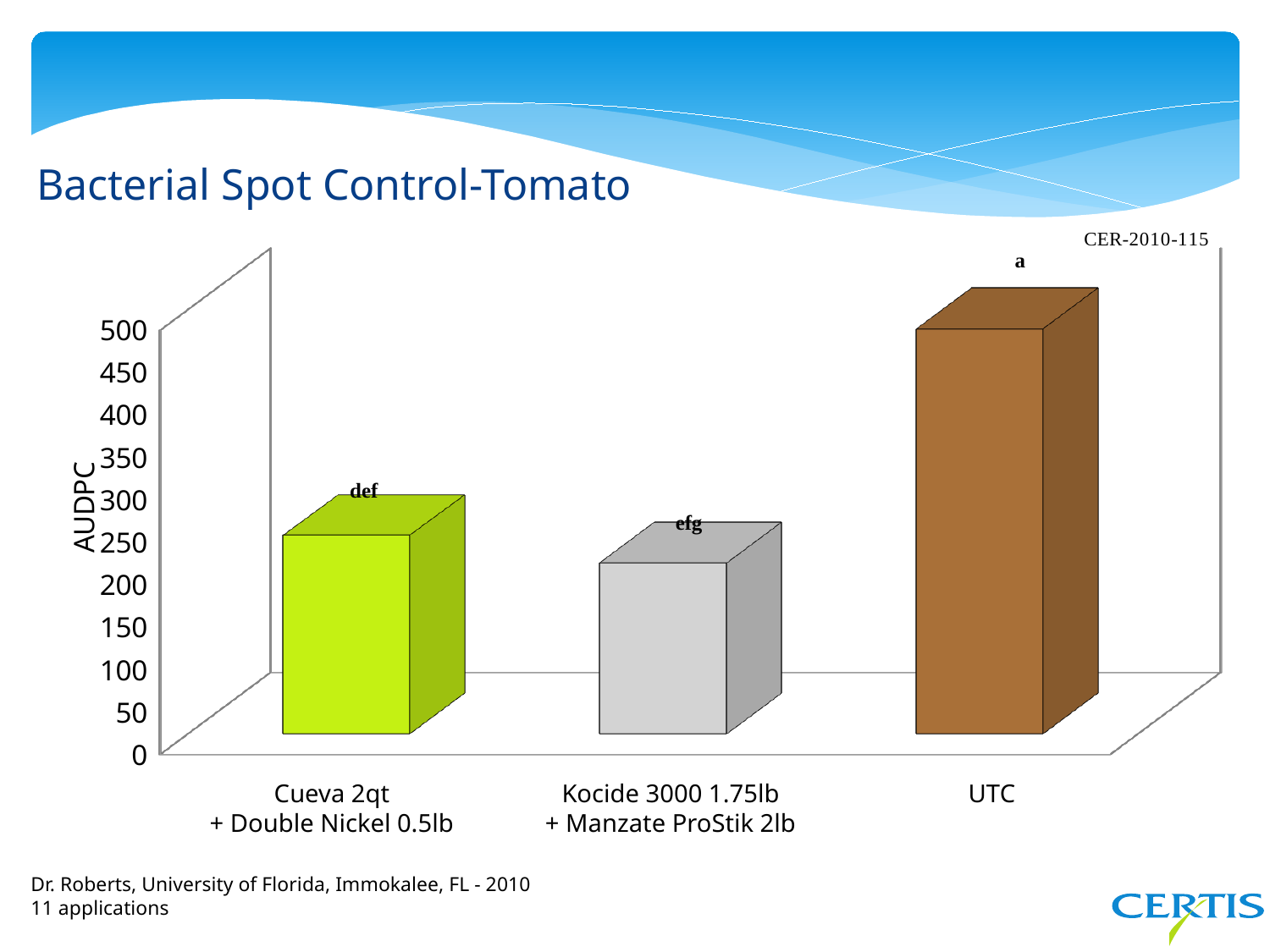
Which has the larger AUDPC value, Cueva 2qt + Double Nickel 0.5lb or Kocide 3000 1.75lb + Manzate ProStik 2lb? Cueva 2qt + Double Nickel 0.5lb What statistical grouping letter is printed above the UTC bar? a Is the AUDPC value for Cueva 2qt + Double Nickel 0.5lb greater or less than 150? greater Which category has the highest AUDPC value? UTC What kind of chart is shown on the slide? bar chart How many treatment categories are plotted in the chart? 3 What is the label on the vertical axis of the chart? AUDPC Is the AUDPC value for Kocide 3000 1.75lb + Manzate ProStik 2lb greater or less than 300? less Which category has the lowest AUDPC value? Kocide 3000 1.75lb + Manzate ProStik 2lb Is the AUDPC value for Cueva 2qt + Double Nickel 0.5lb greater or less than 300? less